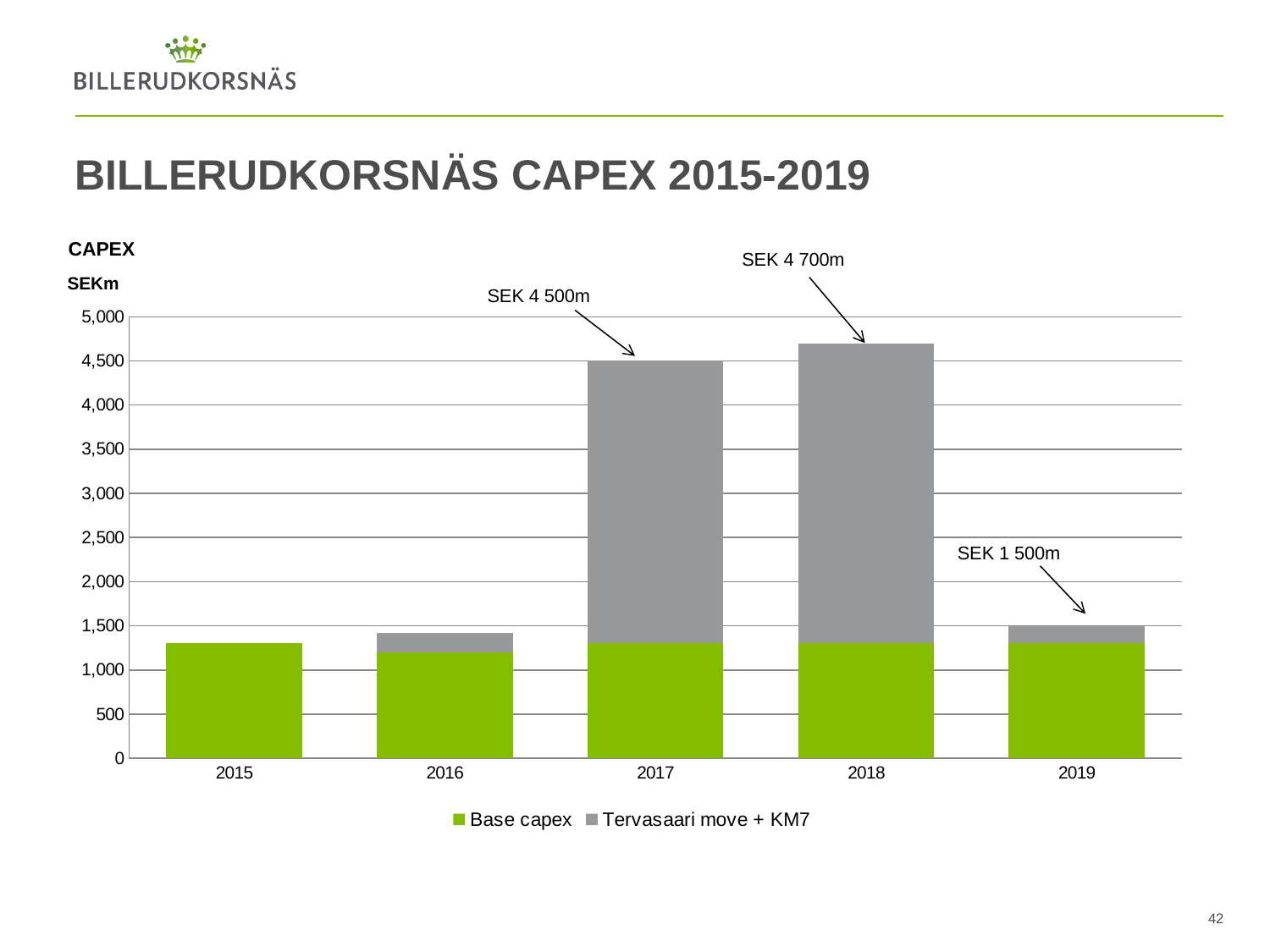
How many series does the legend of the CAPEX chart list? 2 Which is larger, the total capex for 2017 or for 2018? 2018 What is the difference between the labelled total capex for 2018 and 2017? SEK 200m What is the total capex labelled for 2017? SEK 4 500m Which year has the highest total capex? 2018 What are the two series named in the legend of the CAPEX chart? Base capex; Tervasaari move + KM7 How many years are shown on the x axis of the CAPEX chart? 5 Is the total capex for 2015 greater or less than 1,500? less Does total capex rise or fall from 2018 to 2019? fall What is the total capex labelled for 2018? SEK 4 700m What kind of chart is shown on the slide? Stacked bar chart What is the total capex labelled for 2019? SEK 1 500m